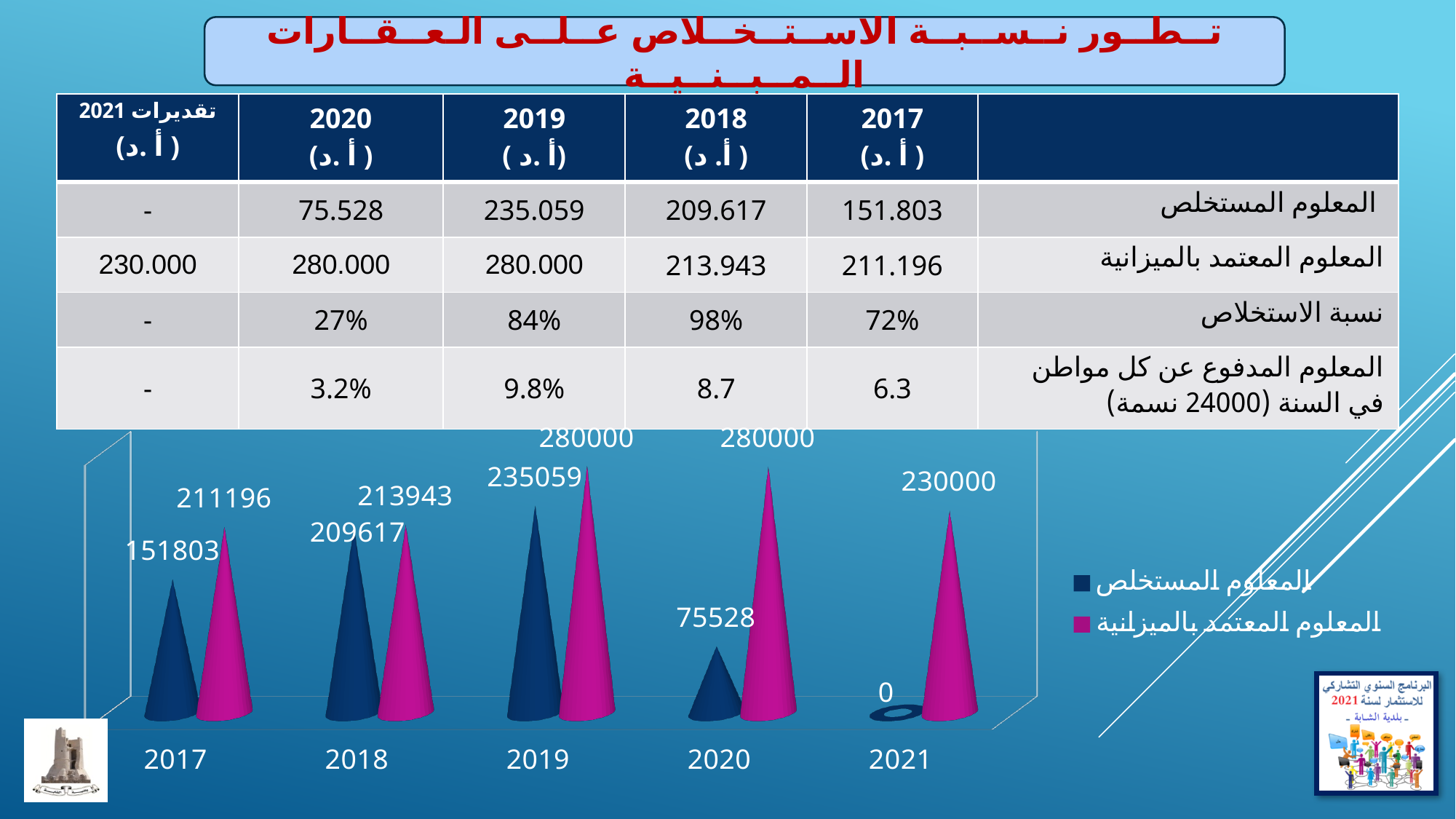
What is the value of المعلوم المستخلص for 2017 in the chart? 151803 In which year is المعلوم المستخلص lowest in the chart? 2021 How many series does the chart legend list? 2 Which is larger in 2017: المعلوم المستخلص or المعلوم المعتمد بالميزانية? المعلوم المعتمد بالميزانية What type of chart is shown on the slide? bar chart What is the value of المعلوم المعتمد بالميزانية for 2021 in the chart? 230000 How many years are shown on the x axis of the chart? 5 In which year is المعلوم المستخلص highest in the chart? 2019 What is the value of المعلوم المعتمد بالميزانية for 2018 in the chart? 213943 Which colour represents المعلوم المعتمد بالميزانية in the chart? magenta What is the value of المعلوم المستخلص for 2020 in the chart? 75528 What is the difference between المعلوم المعتمد بالميزانية and المعلوم المستخلص for 2020 in the chart? 204472